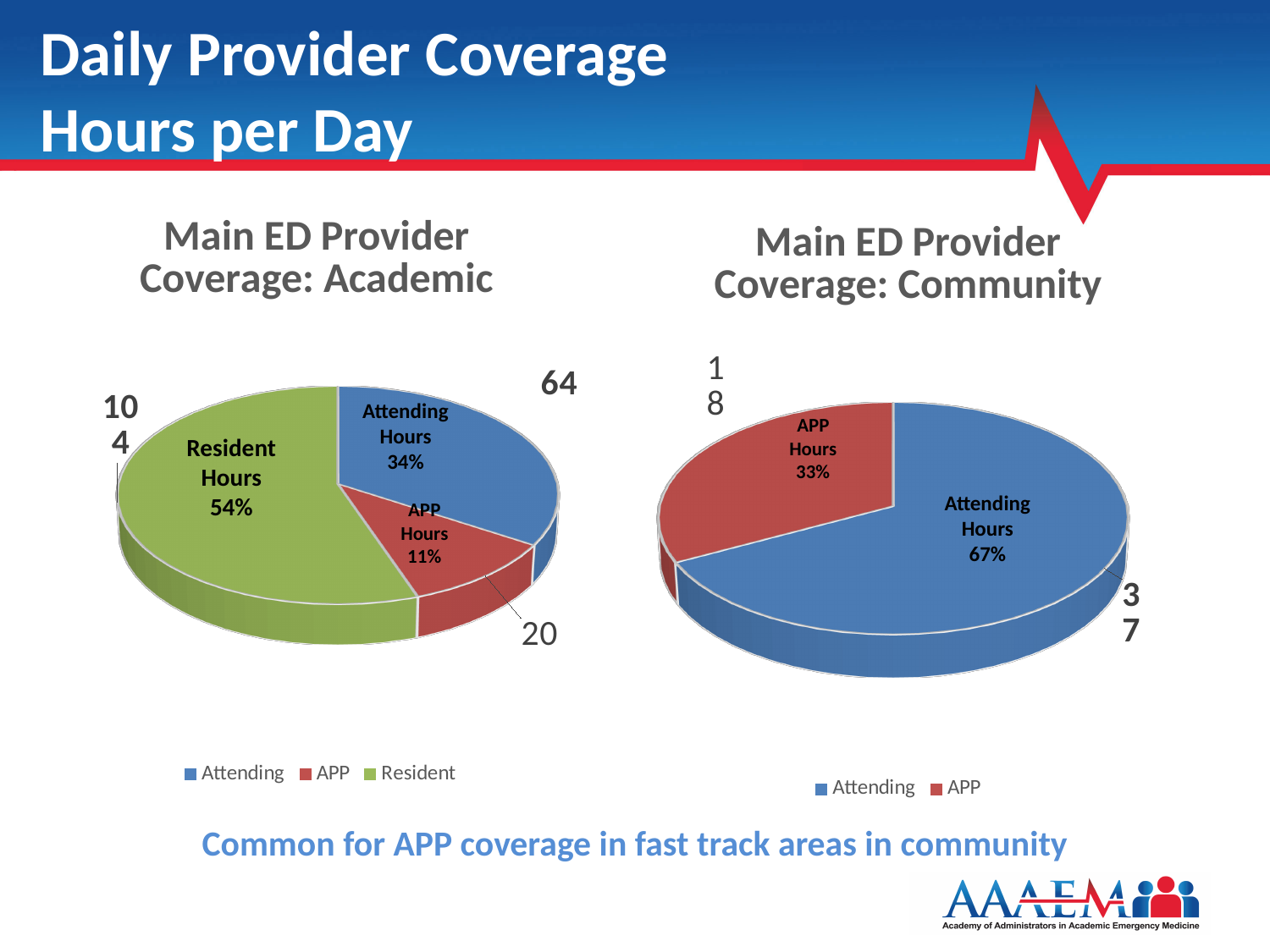
In the 'Main ED Provider Coverage: Academic' chart, which category has the largest slice? Resident In the 'Main ED Provider Coverage: Community' chart, what share of the pie is Attending Hours? 67% In the 'Main ED Provider Coverage: Academic' chart, what is the difference between the Attending value and the APP value? 44 In the 'Main ED Provider Coverage: Community' chart, what share of the pie is APP Hours? 33% In the 'Main ED Provider Coverage: Academic' chart, what share of the pie is APP Hours? 11% How many categories does the legend of the 'Main ED Provider Coverage: Community' chart list? 2 In the 'Main ED Provider Coverage: Academic' chart, which category has the smallest slice? APP In the 'Main ED Provider Coverage: Academic' chart, what is the value for APP? 20 In the 'Main ED Provider Coverage: Academic' chart, what is the value for Attending? 64 What kind of chart is the 'Main ED Provider Coverage: Academic' chart? Pie chart